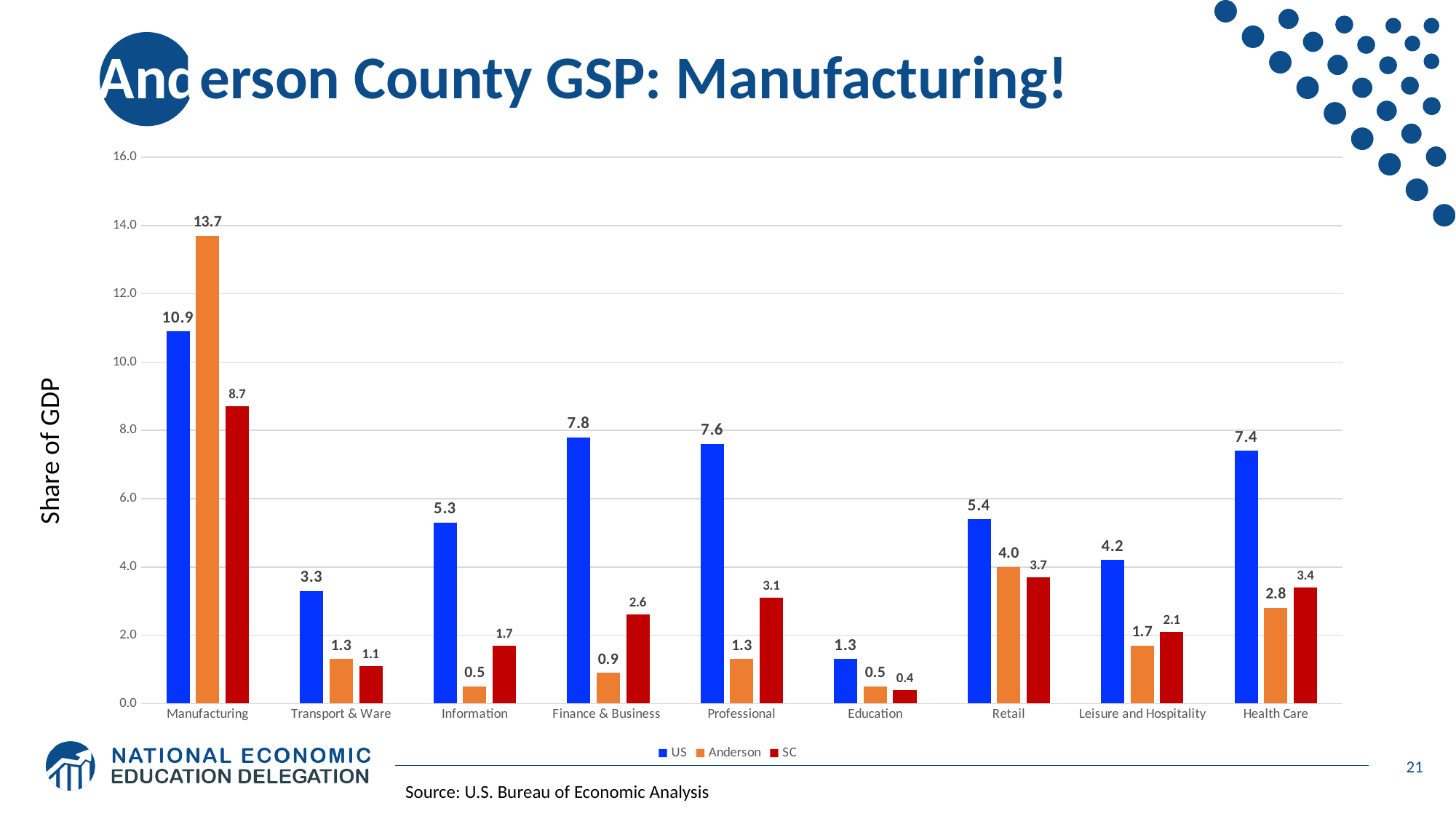
Which category has the highest Anderson value? Manufacturing What is the Anderson value for Manufacturing? 13.7 How many categories are shown on the x axis? 9 Which category has the lowest SC value? Education What is the SC value for Finance & Business? 2.6 What is the US value for Health Care? 7.4 What is the y-axis label of the chart? Share of GDP What is the difference between the Anderson and US values for Manufacturing? 2.8 What kind of chart is shown on the slide? Bar chart Which is larger for Retail: the Anderson value or the SC value? Anderson How many series does the legend list? 3 Which colour represents the SC series in the legend? Red